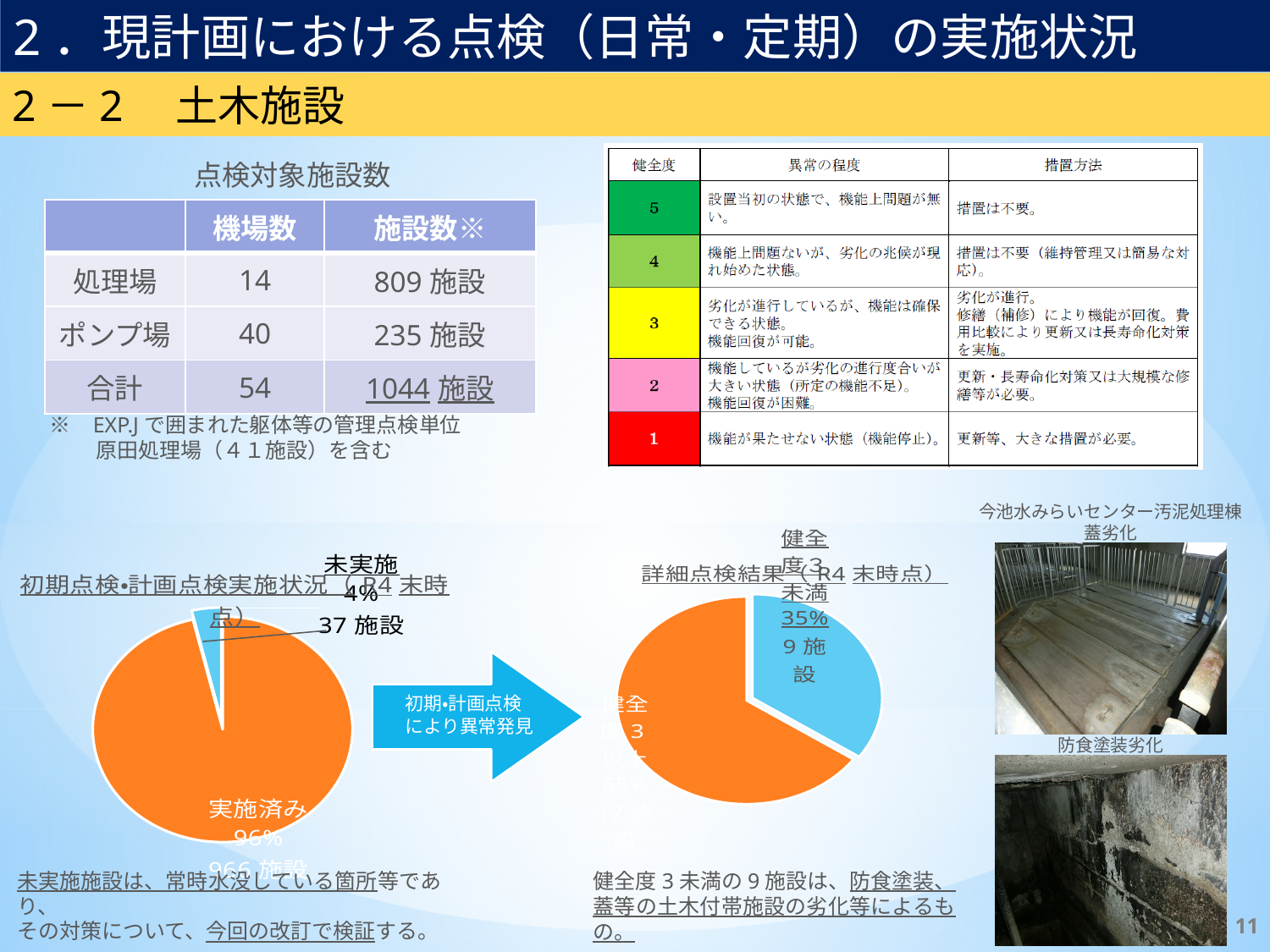
In the left pie chart 初期点検・計画点検実施状況, what percentage share does 実施済み have? 96% In the left pie chart 初期点検・計画点検実施状況, how many facilities are labelled for 未実施? 37 施設 In the right pie chart 詳細点検結果（R4末時点）, what percentage share does 健全度3未満 have? 35% In the right pie chart 詳細点検結果（R4末時点）, which slice is the smallest? 健全度3未満 In the left pie chart 初期点検・計画点検実施状況, how many facilities are labelled for 実施済み? 966 施設 In the left pie chart 初期点検・計画点検実施状況, what percentage share does 未実施 have? 4% What kind of chart is the right chart titled 詳細点検結果（R4末時点）? pie chart In the left pie chart 初期点検・計画点検実施状況, how many slices are there? 2 What kind of chart is the left chart titled 初期点検・計画点検実施状況（R4末時点）? pie chart In the left pie chart 初期点検・計画点検実施状況, what colour is the 未実施 slice? light blue In the right pie chart 詳細点検結果（R4末時点）, how many facilities are labelled for 健全度3未満? 9 施設 In the left pie chart 初期点検・計画点検実施状況, which slice is the largest? 実施済み